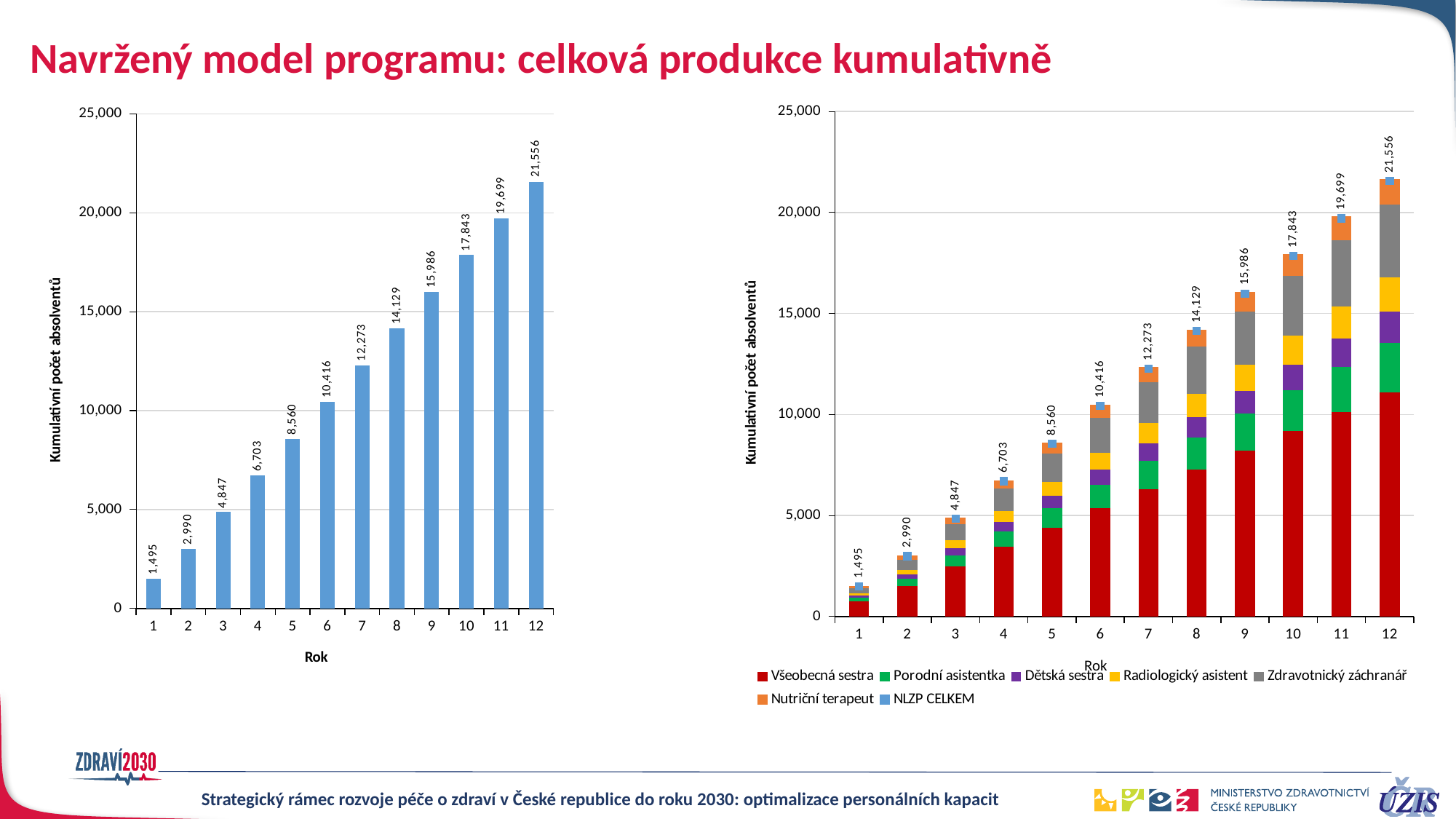
In the left chart, how many years are shown on the x axis? 12 In the left chart, what is the value for year 12? 21,556 In the right chart, which series is shown in red? Všeobecná sestra In the left chart, what is the cumulative number of graduates in year 5? 8,560 In the right chart, is the total for year 3 greater or less than 5,000? less In the left chart, do the values rise or fall from year 1 to year 12? rise In the left chart, is the value for year 7 greater or less than 10,000? greater In the right chart, how many series does the legend list? 7 In the right chart, what is the total labelled above the stacked bar for year 8? 14,129 In the left chart, which year has the lowest value? 1 In the left chart, what is the difference between the values for year 10 and year 9? 1,857 What kind of chart is the right chart? stacked bar chart